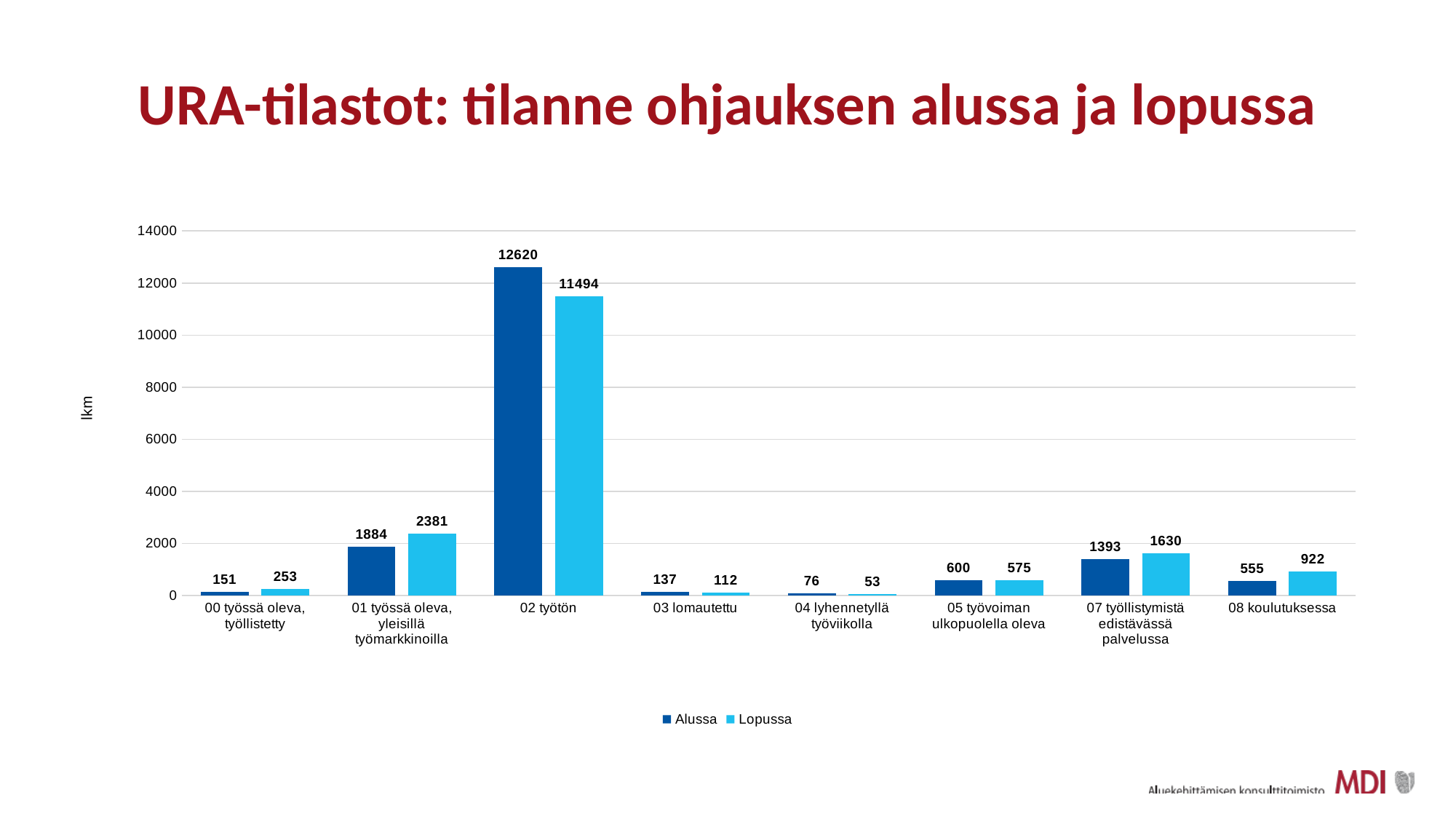
Is the Lopussa value for 02 työtön greater or less than 12000? less What is the difference between the Alussa and Lopussa values for 02 työtön? 1126 What is the Lopussa value for 08 koulutuksessa? 922 How many categories are shown on the x axis? 8 What kind of chart is shown on the slide? bar chart Which category has the lowest Lopussa value? 04 lyhennetyllä työviikolla For 05 työvoiman ulkopuolella oleva, which is larger: the Alussa value or the Lopussa value? Alussa What is the Alussa value for 02 työtön? 12620 Which category has the highest Alussa value? 02 työtön How many series does the legend list? 2 What is the Lopussa value for 01 työssä oleva, yleisillä työmarkkinoilla? 2381 What is the difference between the Lopussa and Alussa values for 07 työllistymistä edistävässä palvelussa? 237